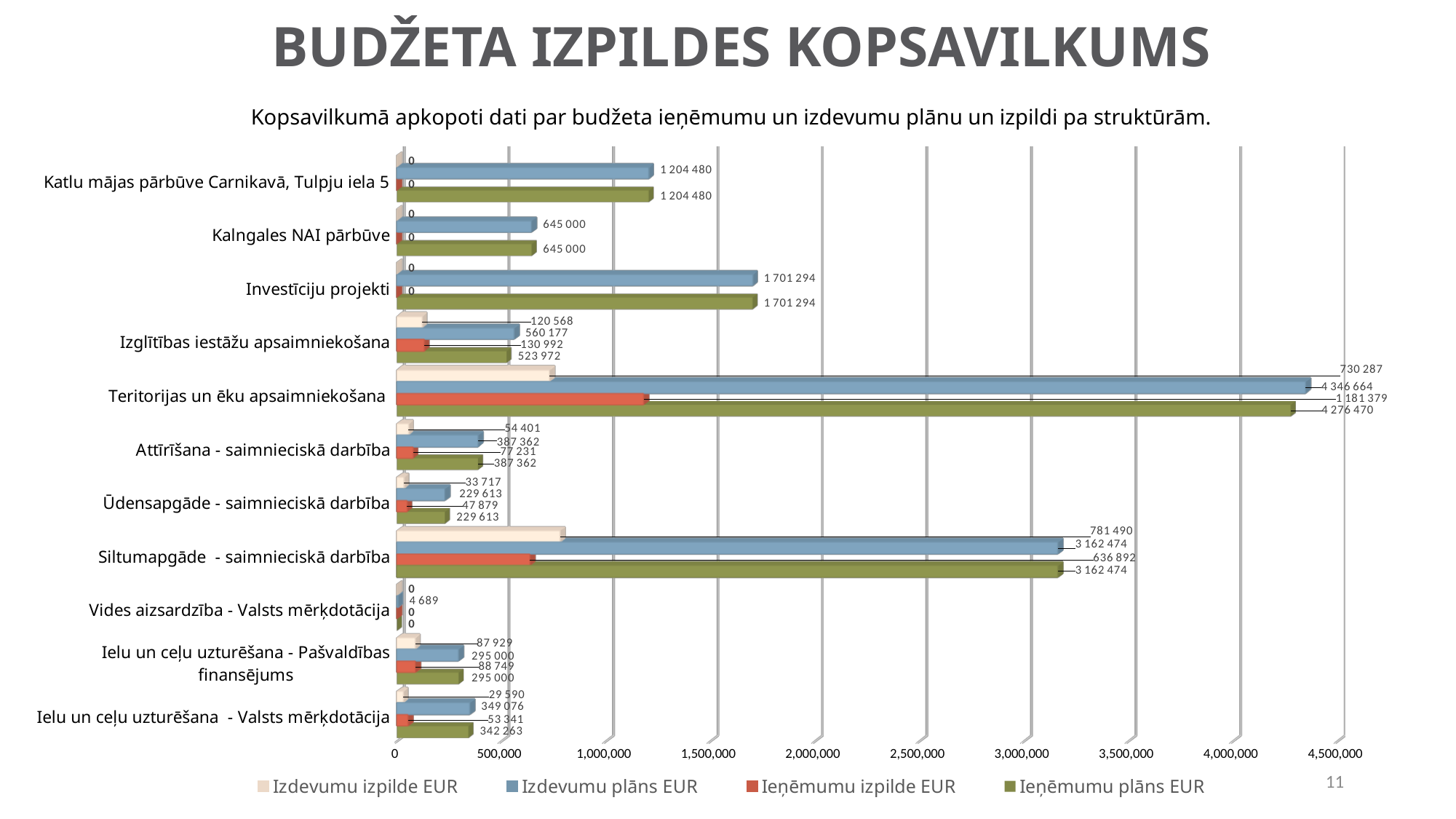
How many series does the legend list? 4 Which is larger for Ielu un ceļu uzturēšana - Valsts mērķdotācija: Ieņēmumu izpilde EUR or Izdevumu izpilde EUR? Ieņēmumu izpilde EUR What is the Izdevumu plāns EUR value for Teritorijas un ēku apsaimniekošana? 4 346 664 What kind of chart is shown on the slide? Bar chart Is the Ieņēmumu plāns EUR value for Teritorijas un ēku apsaimniekošana greater or less than 4,000,000? greater What is the Ieņēmumu izpilde EUR value for Siltumapgāde - saimnieciskā darbība? 636 892 Which category has the lowest Izdevumu plāns EUR value? Vides aizsardzība - Valsts mērķdotācija What is the difference between the Izdevumu plāns EUR and Izdevumu izpilde EUR values for Siltumapgāde - saimnieciskā darbība? 2 380 984 What is the Ieņēmumu plāns EUR value for Kalngales NAI pārbūve? 645 000 Which category has the highest Izdevumu plāns EUR value? Teritorijas un ēku apsaimniekošana What is the Izdevumu izpilde EUR value for Izglītības iestāžu apsaimniekošana? 120 568 How many categories are shown on the chart? 11